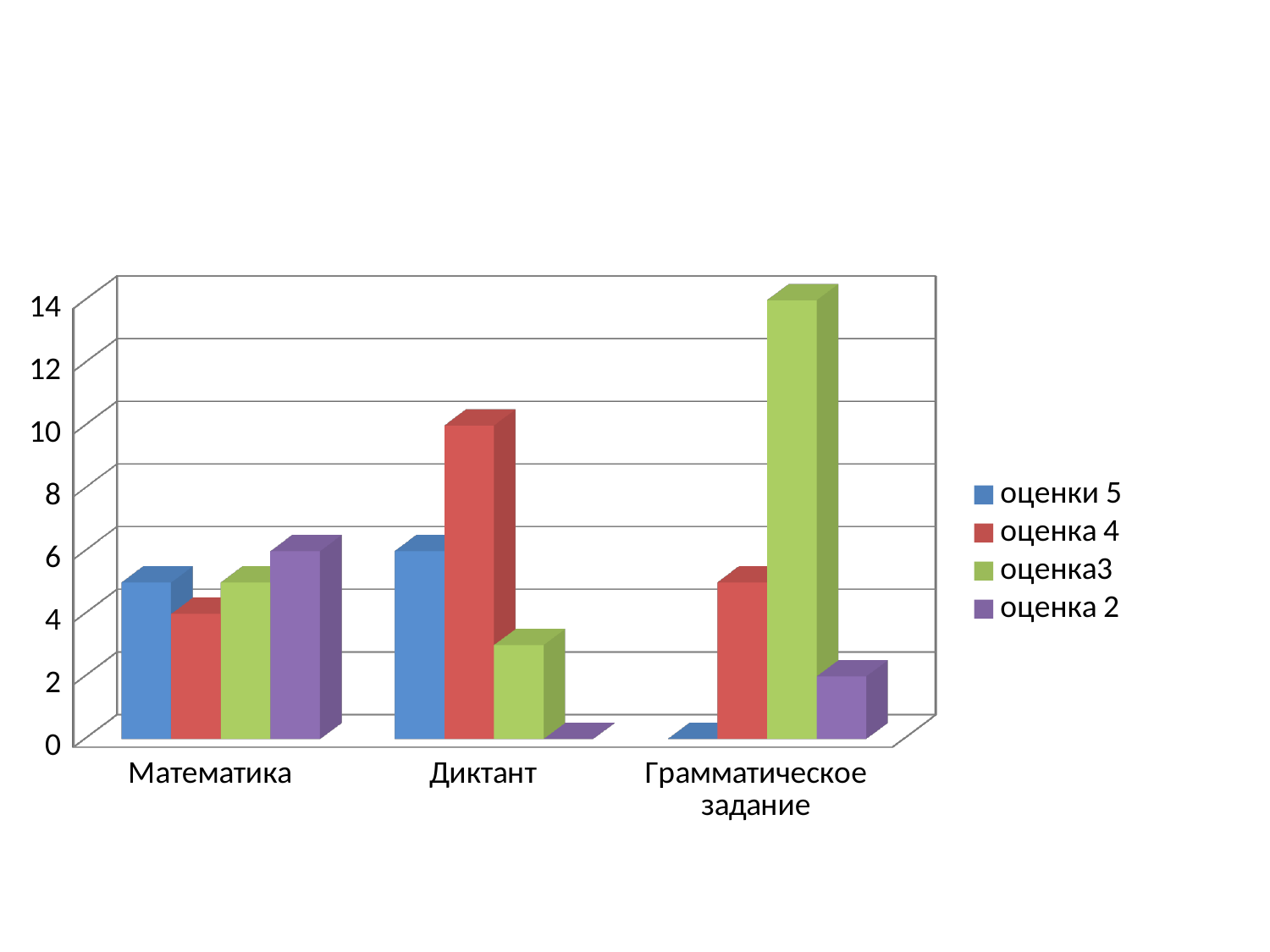
Which category has the tallest bar for the series оценка3? Грамматическое задание Is the value for оценка3 in Грамматическое задание greater or less than 12? greater Is the value for оценка3 in Диктант greater or less than 4? less How many series does the legend list? 4 Which category has the tallest bar for the series оценка 4? Диктант Which is larger in Грамматическое задание: the bar for оценка 4 or the bar for оценка 2? оценка 4 How many categories are shown on the x axis? 3 Which is larger in Диктант: the bar for оценки 5 or the bar for оценка 4? оценка 4 What kind of chart is shown on the slide? bar chart Which category has the tallest bar for the series оценка 2? Математика Is the value for оценка 4 in Диктант greater or less than 8? greater What colour represents the series оценка 2 in the legend? purple